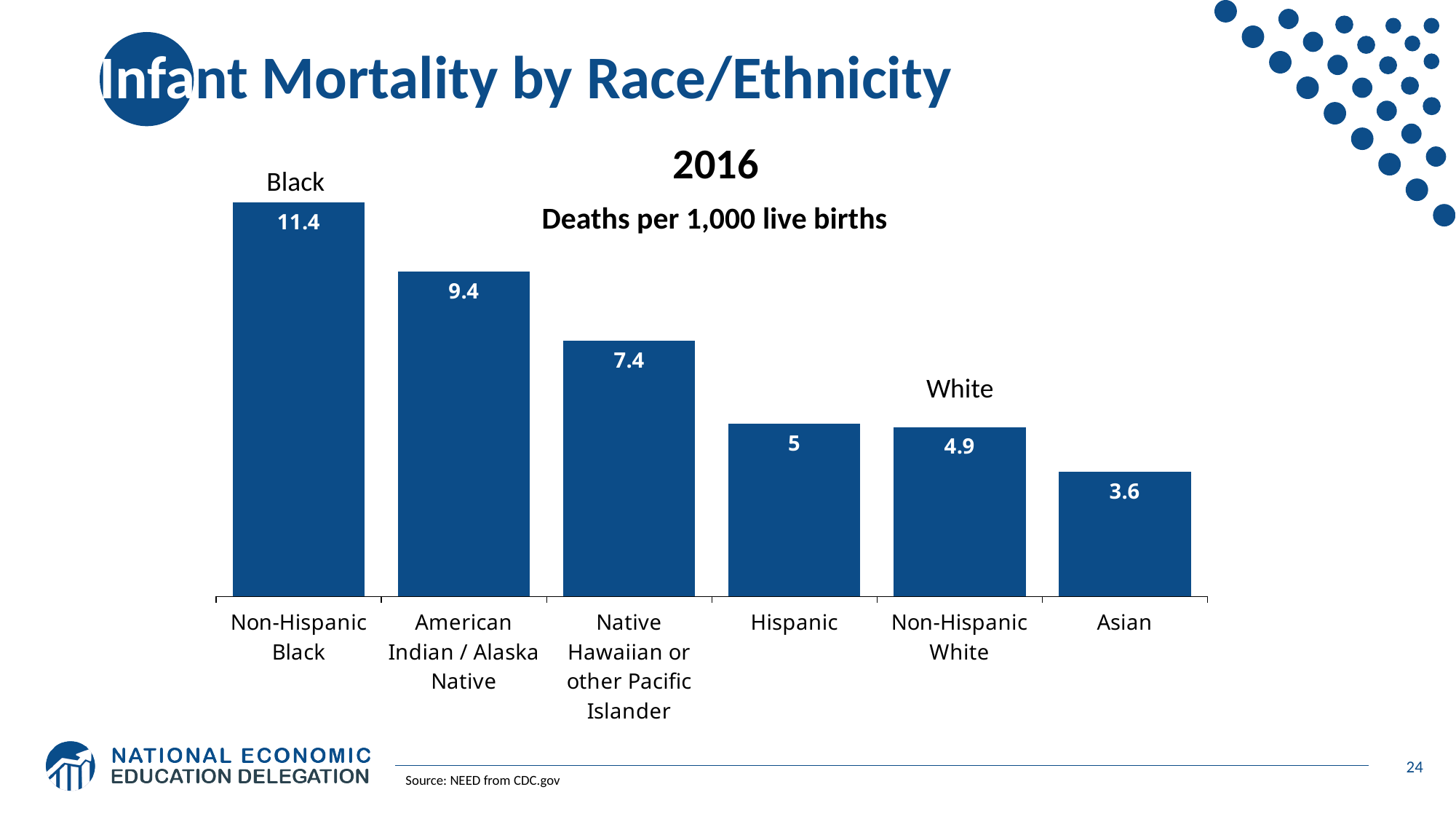
What is the infant mortality rate for Native Hawaiian or other Pacific Islander? 7.4 What unit is the chart measured in, according to the subtitle? Deaths per 1,000 live births What is the difference between the infant mortality rates for Non-Hispanic Black and Non-Hispanic White? 6.5 What is the infant mortality rate for American Indian / Alaska Native? 9.4 What kind of chart is shown on the slide? Bar chart How many race/ethnicity categories are shown in the chart? 6 What is the infant mortality rate for Hispanic? 5 Which has a higher infant mortality rate, Hispanic or Asian? Hispanic What is the infant mortality rate for Asian? 3.6 Which category has the lowest infant mortality rate? Asian Which category has the highest infant mortality rate? Non-Hispanic Black What is the infant mortality rate for Non-Hispanic Black? 11.4